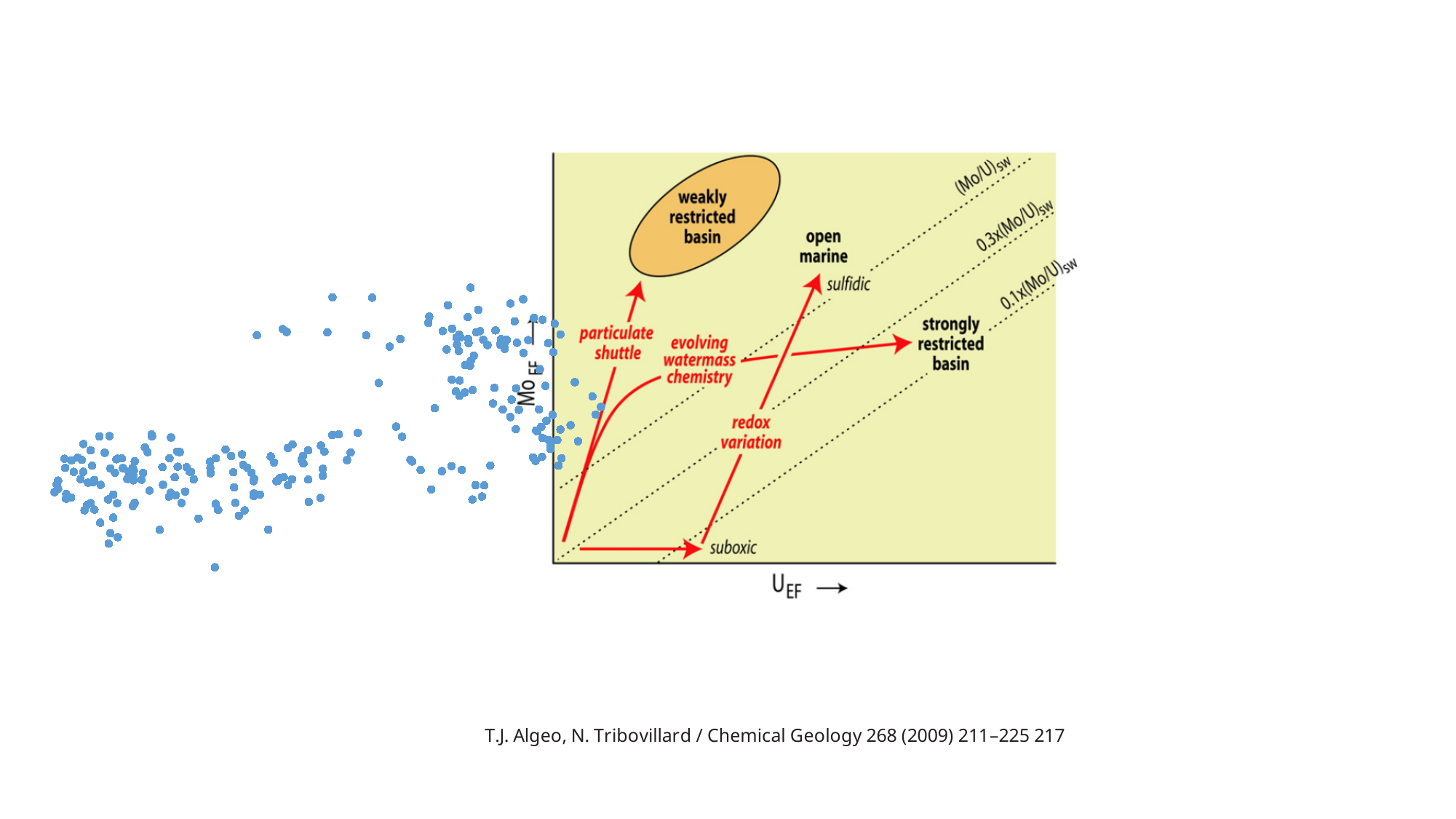
Which of the three dotted reference lines lies highest on the chart? (Mo/U)SW What kind of chart is shown on the slide? A scatter chart What is the label on the x axis of the chart? U_EF Which of the three dotted reference lines lies lowest on the chart? 0.1x(Mo/U)SW What is the label on the y axis of the chart? Mo_EF How many dotted reference lines are drawn on the chart? 3